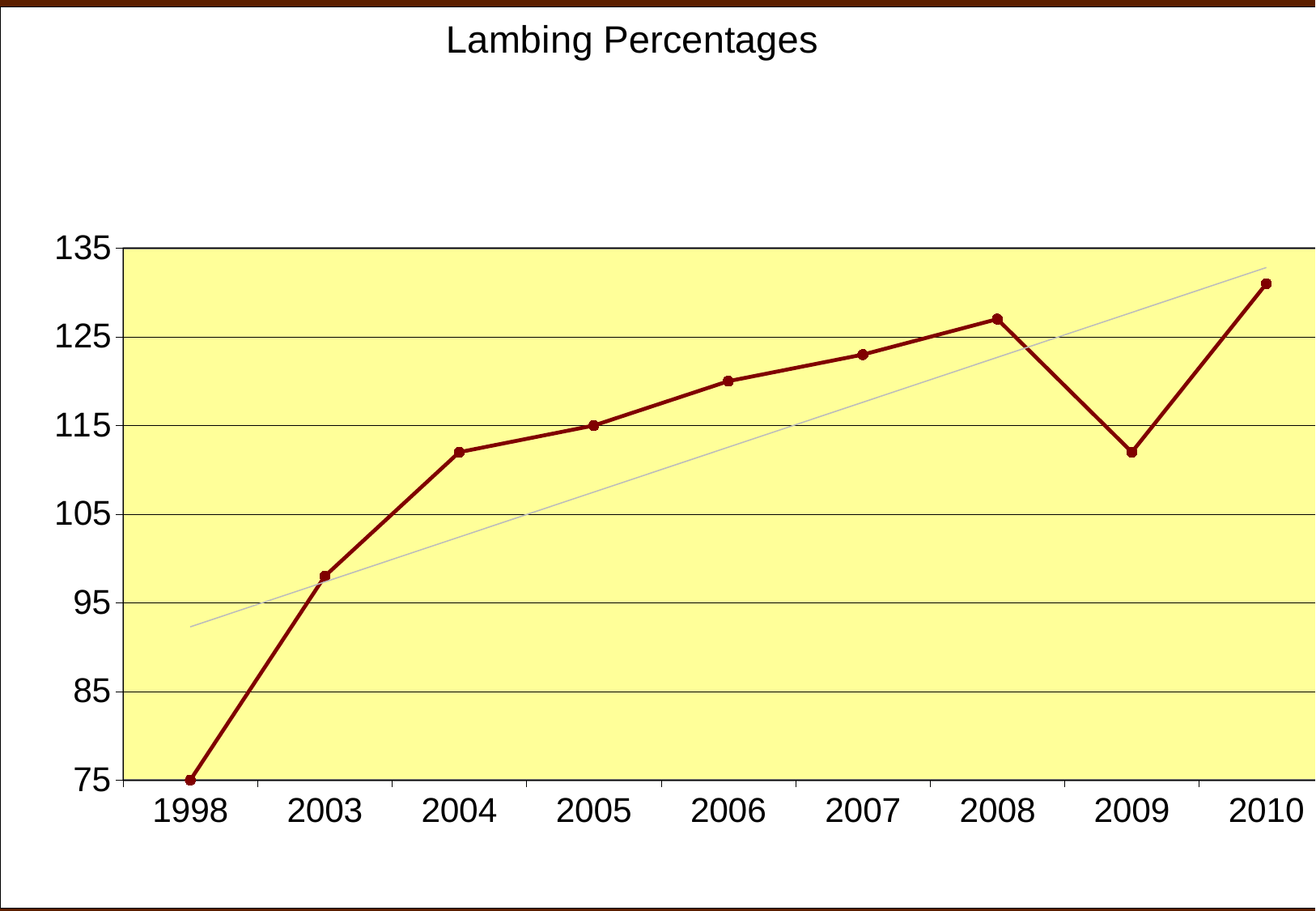
Which year has the highest lambing percentage? 2010 Which year has the lowest lambing percentage? 1998 Do the values generally rise or fall from 1998 to 2008? rise Is the value for 2008 greater or less than 125? greater Is the value for 2009 greater or less than 115? less What kind of chart is shown on the slide? line chart What is the lambing percentage value for 2005? 115 Is the value for 2003 greater or less than 95? greater How many years are plotted on the x axis? 9 What is the title of the chart? Lambing Percentages What is the lambing percentage value for 1998? 75 Which year has the larger value, 2008 or 2009? 2008